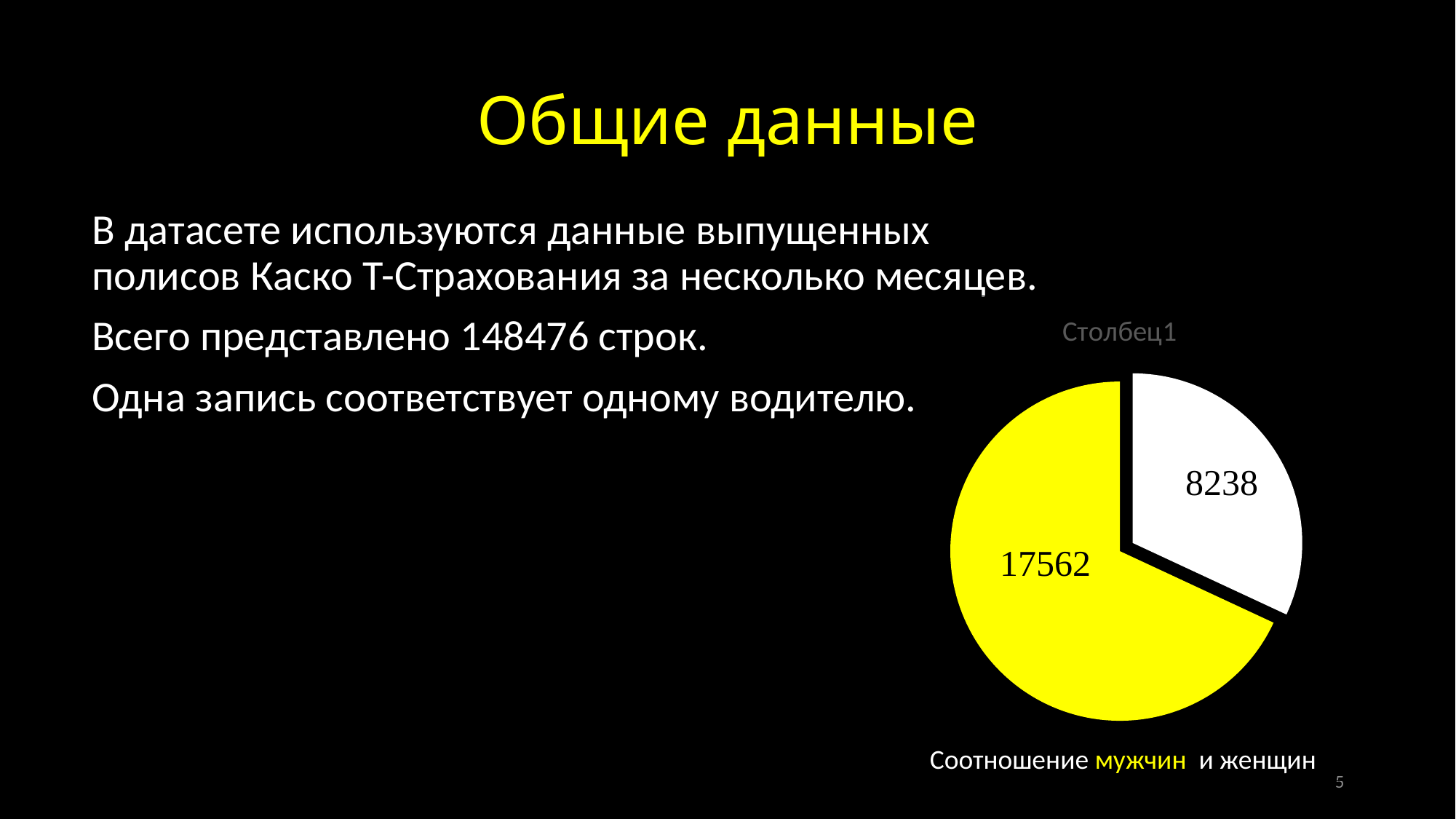
What value is printed on the yellow slice of the pie chart? 17562 What is the difference between the yellow slice value and the white slice value in the pie chart? 9324 What value is printed on the white slice of the pie chart? 8238 Which slice of the pie chart has the largest value? the yellow slice (17562) What share of the pie does the yellow slice (17562) represent, to the nearest percent? 68% What kind of chart is shown on the slide? pie chart Which is larger in the pie chart, the yellow slice or the white slice? the yellow slice What is the total of the two values shown in the pie chart? 25800 How many slices does the pie chart have? 2 What is the title shown above the pie chart? Столбец1 According to the caption below the pie chart, which group does the yellow colour represent? мужчин (men) Which slice of the pie chart has the smallest value? the white slice (8238)